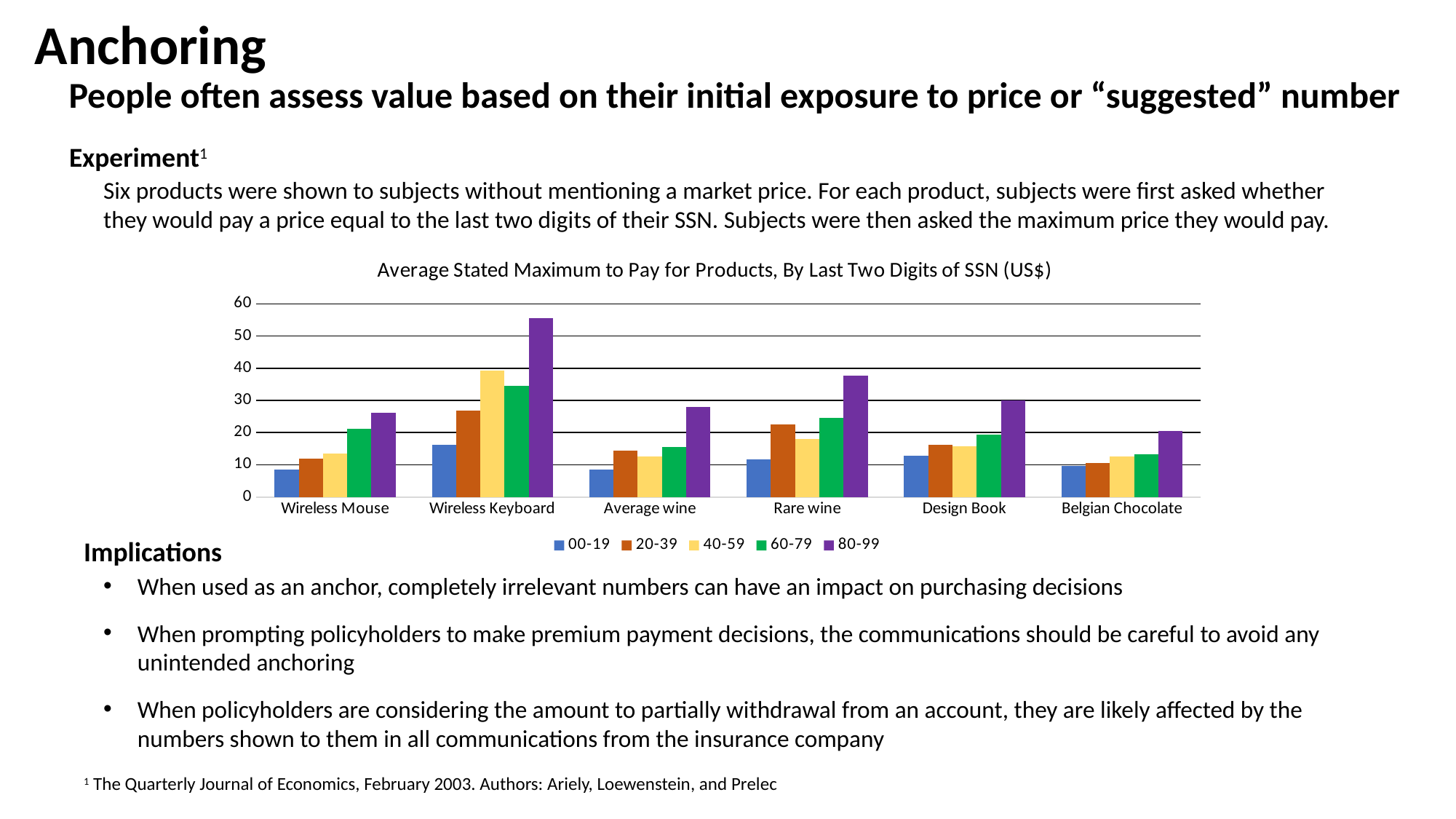
Is the value for the 00-19 group for Wireless Mouse greater or less than 10? less For Wireless Keyboard, which group has the larger value: 40-59 or 60-79? 40-59 How many series does the legend list in the chart? 5 Is the value for the 00-19 group for Rare wine greater or less than 20? less What type of chart is shown on the slide? Bar chart Is the value for the 80-99 group for Rare wine greater or less than 30? greater How many products are shown on the x axis of the chart? 6 Which SSN digit group is shown in purple in the chart? 80-99 What is the title of the chart? Average Stated Maximum to Pay for Products, By Last Two Digits of SSN (US$) For which product is the 80-99 bar the highest? Wireless Keyboard For which product is the 80-99 bar the lowest? Belgian Chocolate